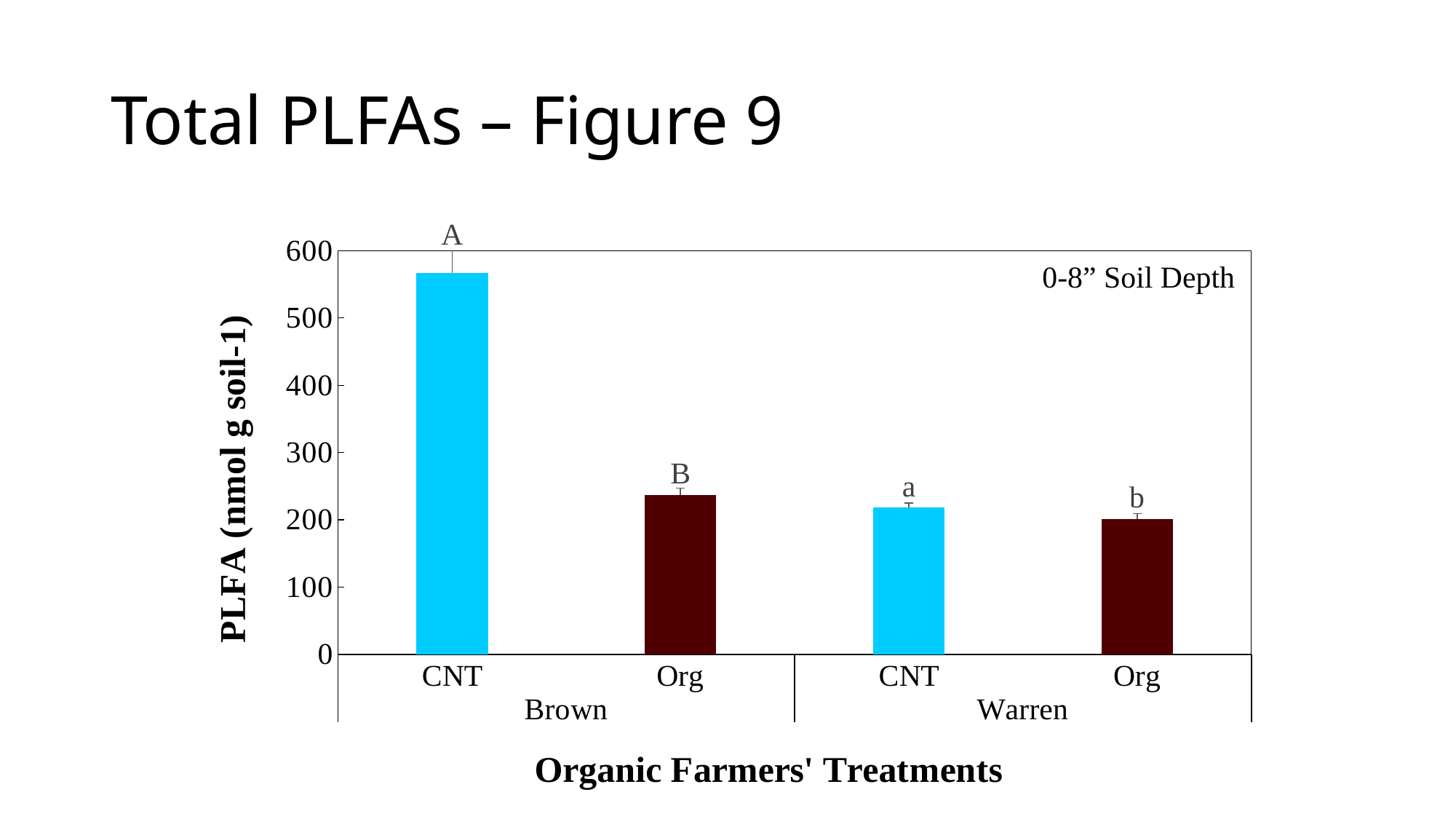
Which bar has the highest PLFA value? Brown CNT Which is larger, the PLFA value for Brown Org or for Warren Org? Brown Org What is the label on the y axis of the chart? PLFA (nmol g soil-1) Is the PLFA value for Warren Org greater or less than 100? greater How many bars are plotted in the chart? 4 What soil depth is noted in the top right corner of the chart? 0-8" Soil Depth Do the bar values rise or fall from left to right across the chart? fall Is the PLFA value for Brown Org greater or less than 300? less Which is larger, the PLFA value for Brown CNT or for Brown Org? Brown CNT Is the PLFA value for Warren CNT greater or less than 300? less What kind of chart is shown on the slide? bar chart